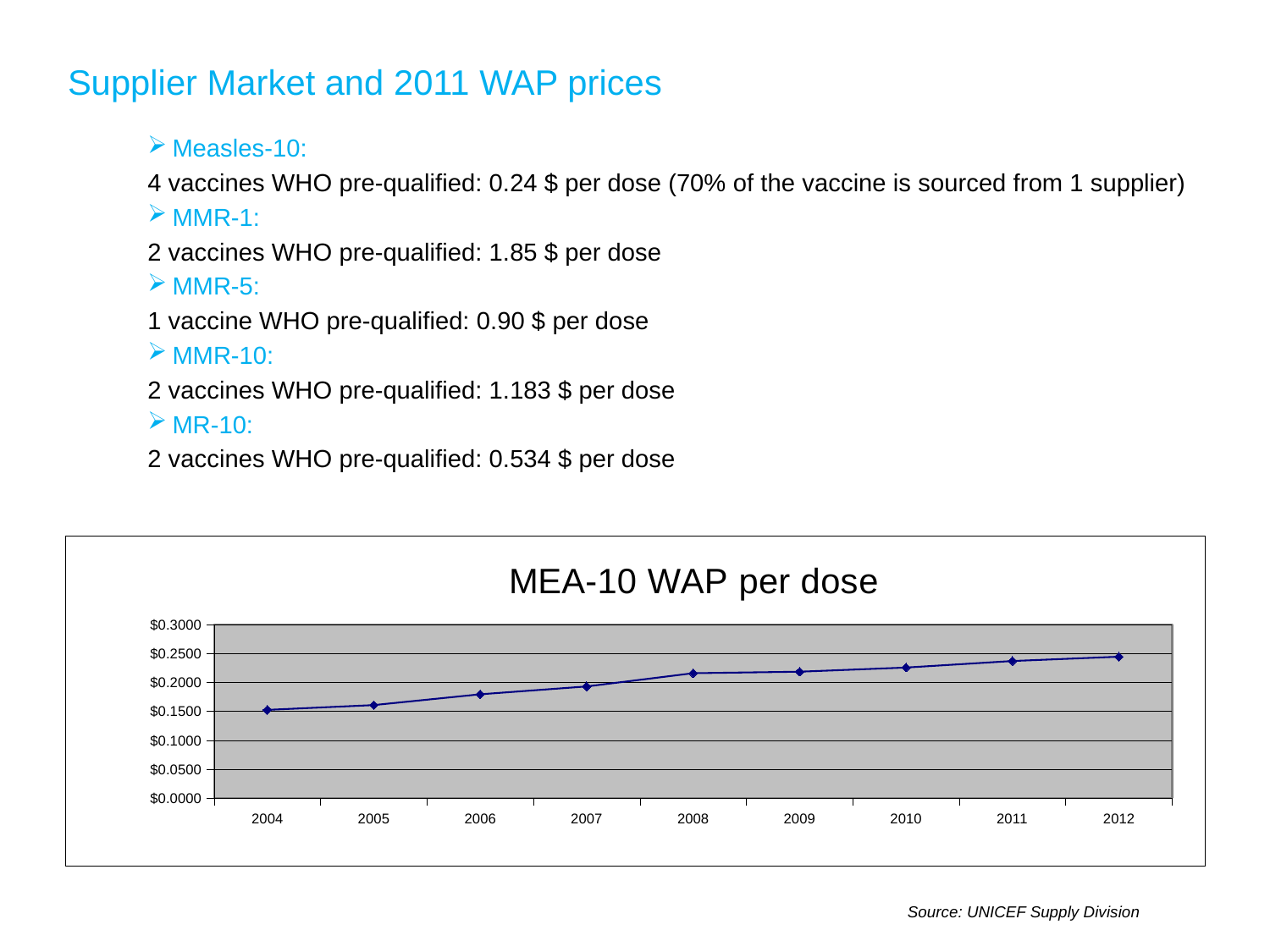
Do the values rise or fall from 2004 to 2012? rise Which year has the highest MEA-10 WAP per dose? 2012 What kind of chart is shown on the slide? line chart Which is larger, the value for 2004 or the value for 2012? 2012 Which year has the lowest MEA-10 WAP per dose? 2004 What is the title of the chart? MEA-10 WAP per dose Is the value for 2006 greater or less than $0.2000? less What source is cited for the chart? UNICEF Supply Division Is the value for 2004 greater or less than $0.2000? less Is the value for 2004 greater or less than $0.1000? greater How many years are plotted on the x axis of the chart? 9